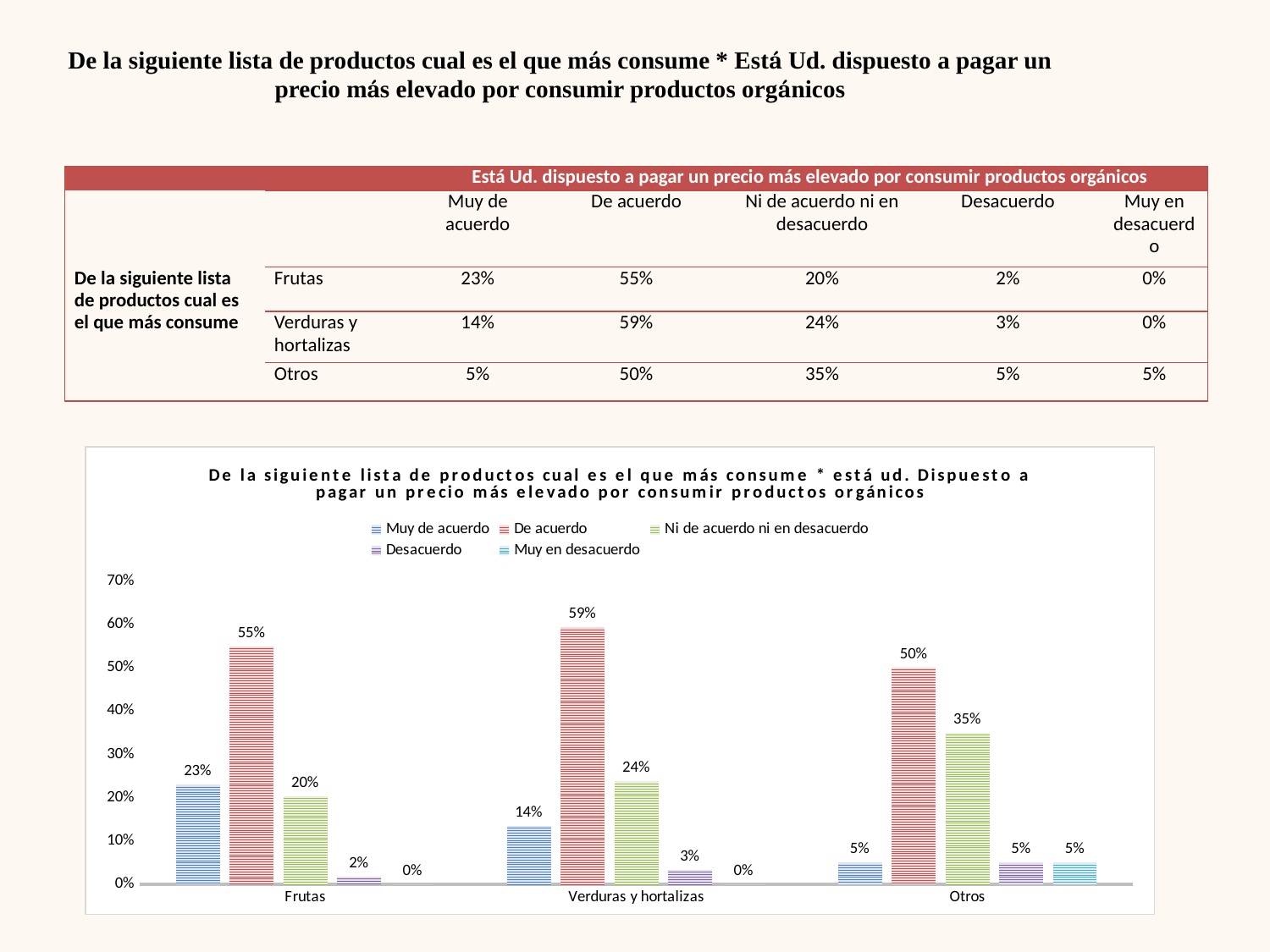
Which is larger: "Ni de acuerdo ni en desacuerdo" for Frutas or for Verduras y hortalizas? Verduras y hortalizas What is the value for "Muy de acuerdo" in the Verduras y hortalizas category? 14% Which category has the lowest value for "Muy de acuerdo"? Otros What is the difference between the "De acuerdo" values for Verduras y hortalizas and Otros? 9% What is the value for "De acuerdo" in the Frutas category? 55% How many product categories are shown on the x axis? 3 How many series does the legend list? 5 What is the value for "Muy en desacuerdo" in the Otros category? 5% What is the value for "Ni de acuerdo ni en desacuerdo" in the Otros category? 35% What kind of chart is shown on the slide? bar chart Which category has the highest value for "De acuerdo"? Verduras y hortalizas Is the value for "De acuerdo" in the Otros category greater or less than 40%? greater